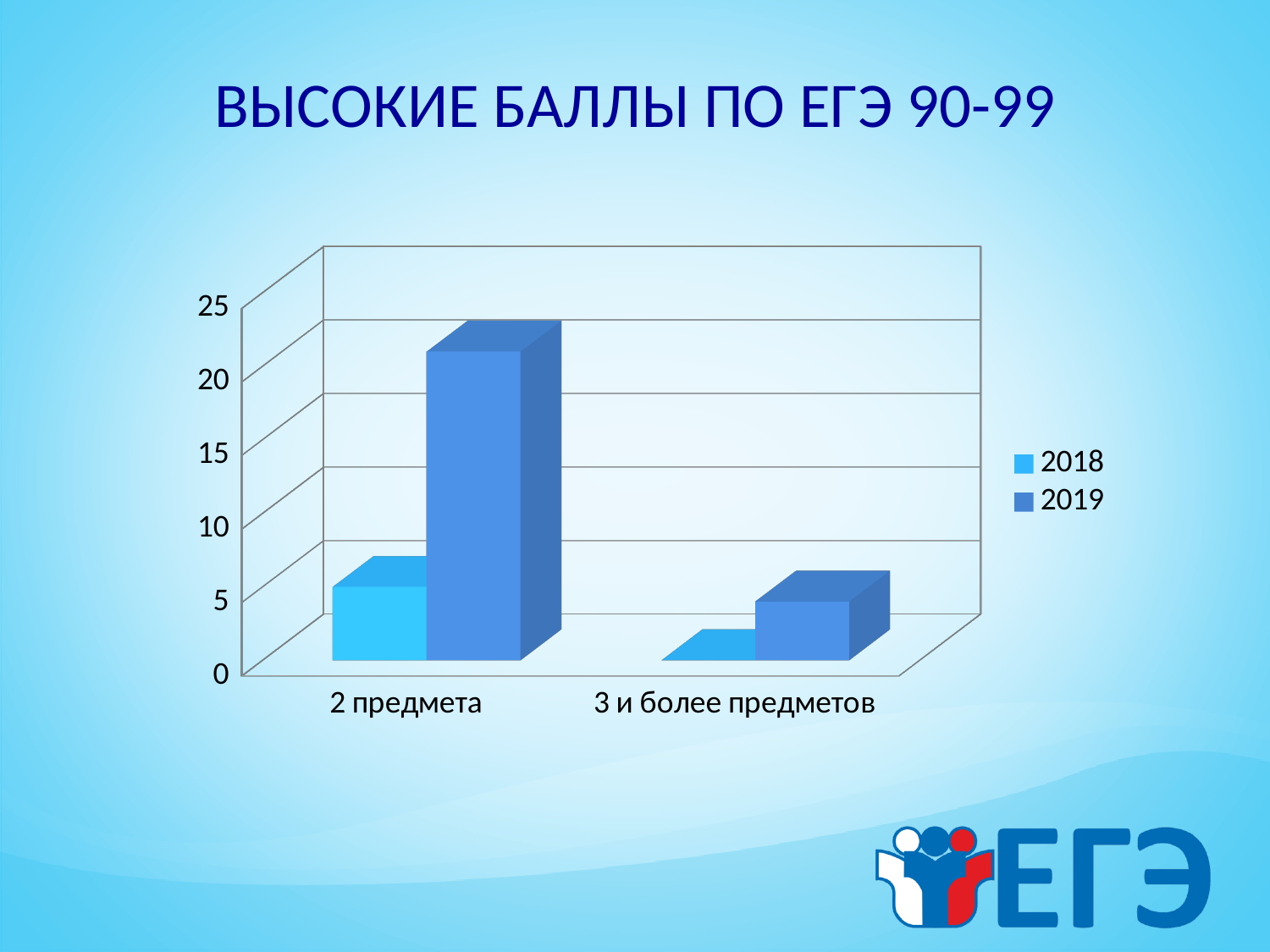
How many categories are shown on the x axis? 2 How many series does the legend list? 2 For the category "3 и более предметов", which series has the larger value, 2018 or 2019? 2019 For the category "2 предмета", which series has the larger value, 2018 or 2019? 2019 Which category has the highest value for the 2019 series? 2 предмета Is the 2018 value for "2 предмета" greater or less than 10? less What is the title of the chart? ВЫСОКИЕ БАЛЛЫ ПО ЕГЭ 90-99 Is the 2018 value for "3 и более предметов" greater or less than 5? less Is the 2019 value for "2 предмета" greater or less than 15? greater What kind of chart is shown on the slide? bar chart Which series are listed in the legend? 2018, 2019 Which category has the lowest value for the 2018 series? 3 и более предметов